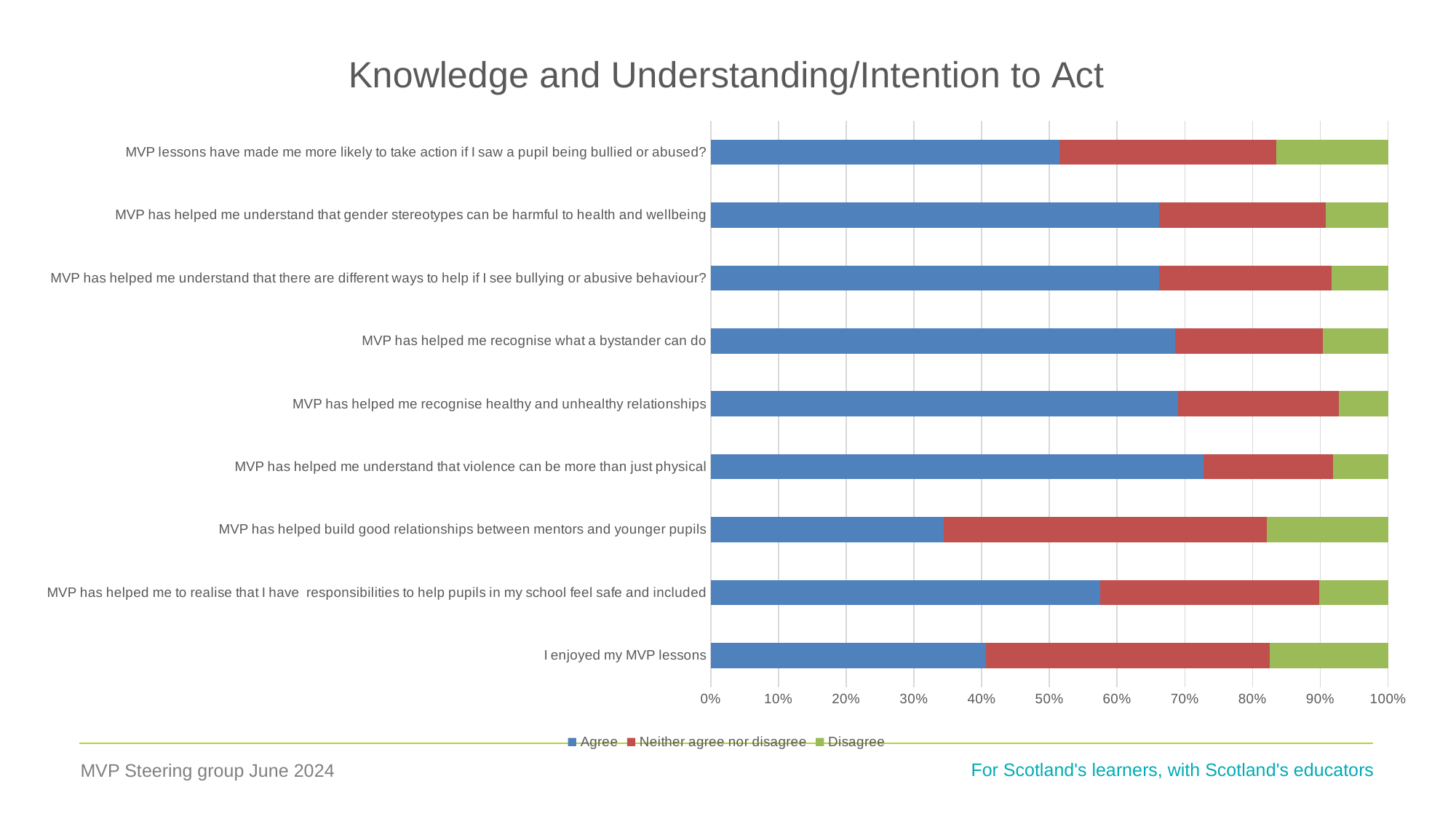
Which statement has a larger 'Agree' share: 'MVP has helped me understand that gender stereotypes can be harmful to health and wellbeing' or 'MVP has helped build good relationships between mentors and younger pupils'? MVP has helped me understand that gender stereotypes can be harmful to health and wellbeing Which statement has a larger 'Disagree' share: 'MVP has helped build good relationships between mentors and younger pupils' or 'MVP has helped me recognise healthy and unhealthy relationships'? MVP has helped build good relationships between mentors and younger pupils Which statement has the highest share of 'Agree' responses? MVP has helped me understand that violence can be more than just physical Which statement has the lowest share of 'Agree' responses? MVP has helped build good relationships between mentors and younger pupils What is the title of the chart? Knowledge and Understanding/Intention to Act Is the 'Agree' share for 'MVP has helped me recognise what a bystander can do' greater or less than 60%? greater Is the 'Agree' share for 'MVP lessons have made me more likely to take action if I saw a pupil being bullied or abused?' greater or less than 60%? less How many statements (categories) are plotted on the chart? 9 Which colour represents the 'Disagree' series in the chart? Green Is the 'Agree' share for 'I enjoyed my MVP lessons' greater or less than 50%? less How many series does the legend list? 3 What kind of chart is shown on the slide? Stacked bar chart